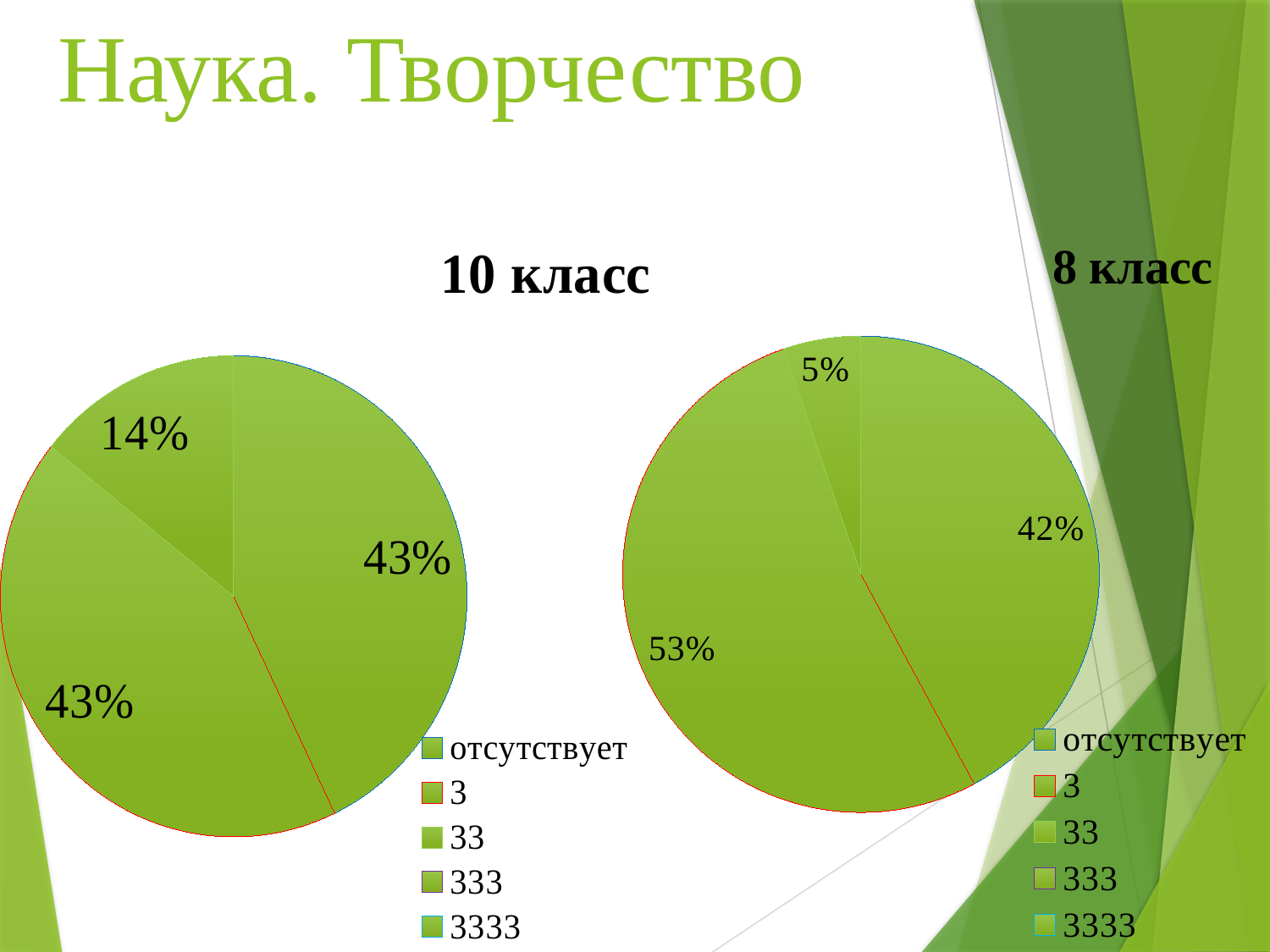
In the "8 класс" pie chart, which is larger: the slice labelled 42% or the slice labelled 53%? 53% In the "8 класс" pie chart, what is the difference in percentage points between the 53% slice and the 5% slice? 48 In the "10 класс" pie chart, how many slices have a percentage label? 3 In the "8 класс" pie chart, what is the smallest percentage shown on a slice? 5% In the "10 класс" pie chart, what is the largest percentage shown on a slice? 43% In the "8 класс" pie chart, what is the largest percentage shown on a slice? 53% How many entries does the legend of the "10 класс" chart list? 5 What is the title of the pie chart on the right side of the slide? 8 класс In the "10 класс" pie chart, what is the difference in percentage points between the largest slice (43%) and the smallest slice (14%)? 29 In the "10 класс" pie chart, what is the smallest percentage shown on a slice? 14% In the "8 класс" pie chart, how many slices have a percentage label? 3 What kind of chart is the "10 класс" chart? pie chart